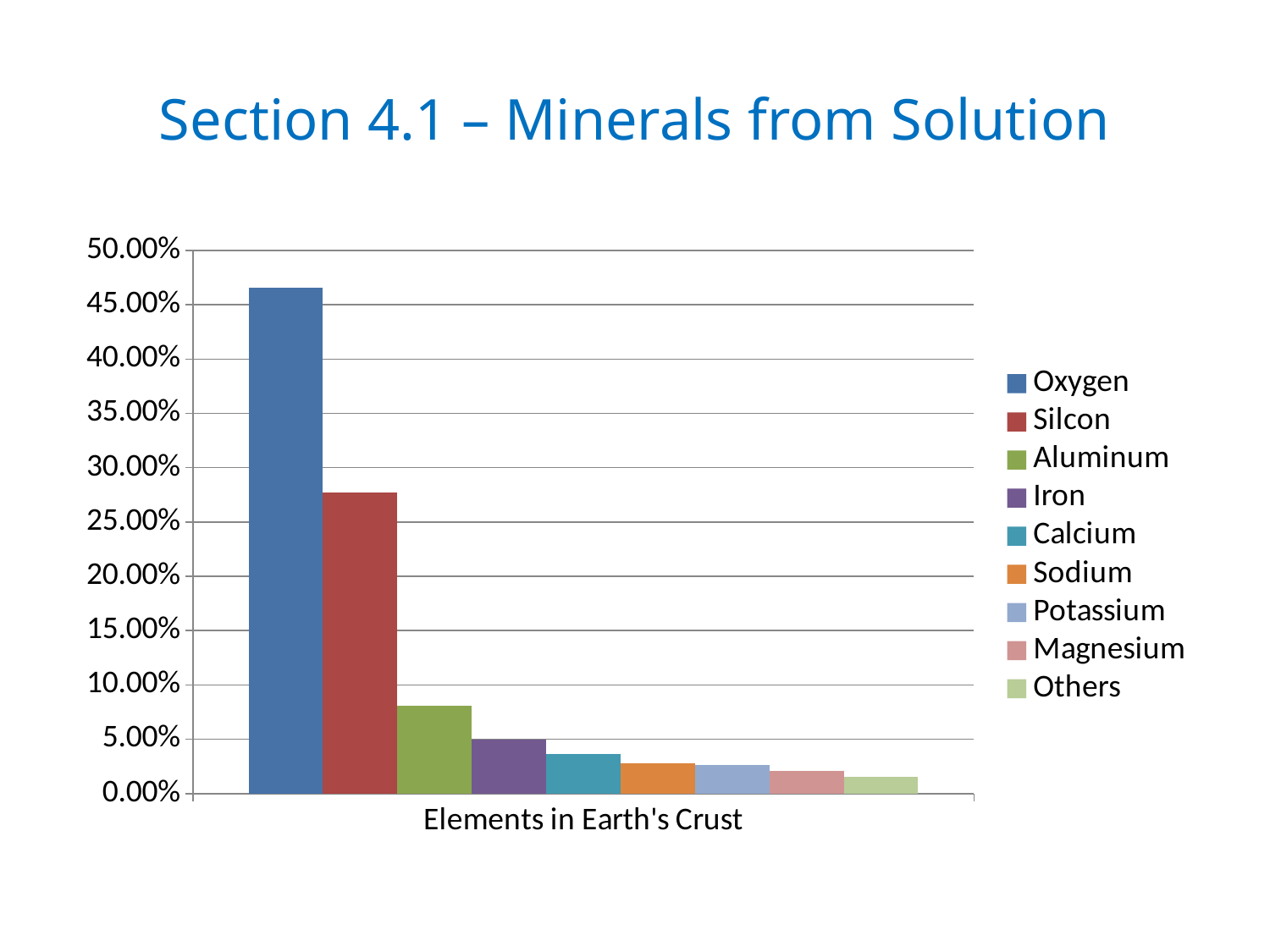
Is the value for Silicon greater or less than 25.00%? greater What kind of chart is shown on the slide? bar chart Which legend entry has the lowest value in the chart? Others Is the value for Calcium greater or less than 5.00%? less Which is larger, the value for Silicon or the value for Aluminum? Silicon How many series does the legend list? 9 Is the value for Oxygen greater or less than 45.00%? greater What is the label shown below the x axis of the chart? Elements in Earth's Crust Which element has the highest value in the chart? Oxygen Which is larger, the value for Iron or the value for Sodium? Iron